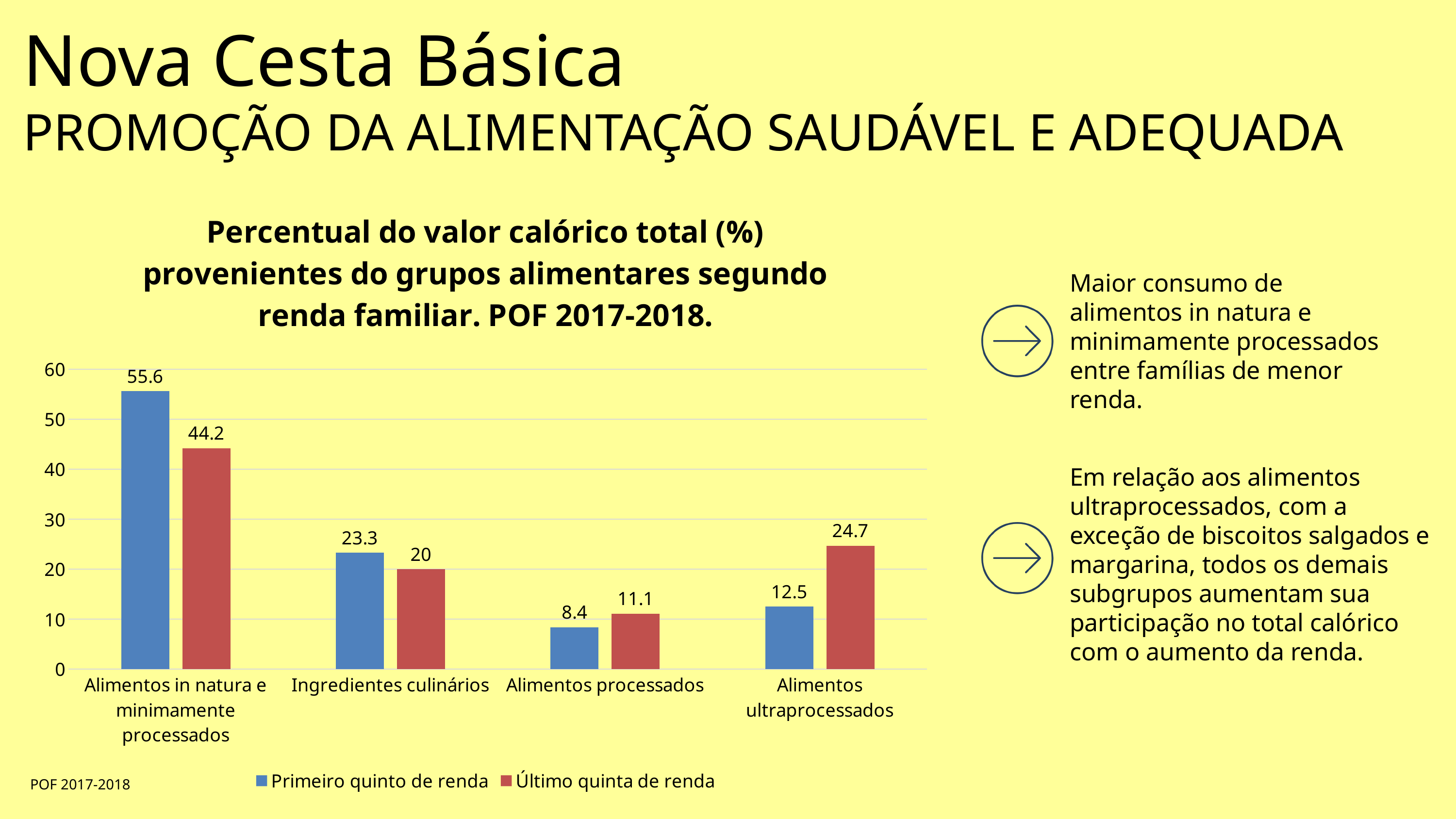
What is the difference between the "Primeiro quinto de renda" and "Último quinta de renda" values for "Alimentos in natura e minimamente processados"? 11.4 What is the value for "Último quinta de renda" in the "Ingredientes culinários" category? 20 How many categories are shown on the x axis of the chart? 4 What is the difference between the "Primeiro quinto de renda" and "Último quinta de renda" values for "Alimentos ultraprocessados"? 12.2 Which colour represents "Último quinta de renda" in the chart? Red Which category has the lowest value for "Último quinta de renda"? Alimentos processados For "Alimentos processados", which series has the larger value: "Primeiro quinto de renda" or "Último quinta de renda"? Último quinta de renda How many series does the chart legend list? 2 What is the value for "Último quinta de renda" in the "Alimentos ultraprocessados" category? 24.7 What kind of chart is shown on the slide? Bar chart Which category has the highest value for "Primeiro quinto de renda"? Alimentos in natura e minimamente processados What is the value for "Primeiro quinto de renda" in the "Alimentos in natura e minimamente processados" category? 55.6